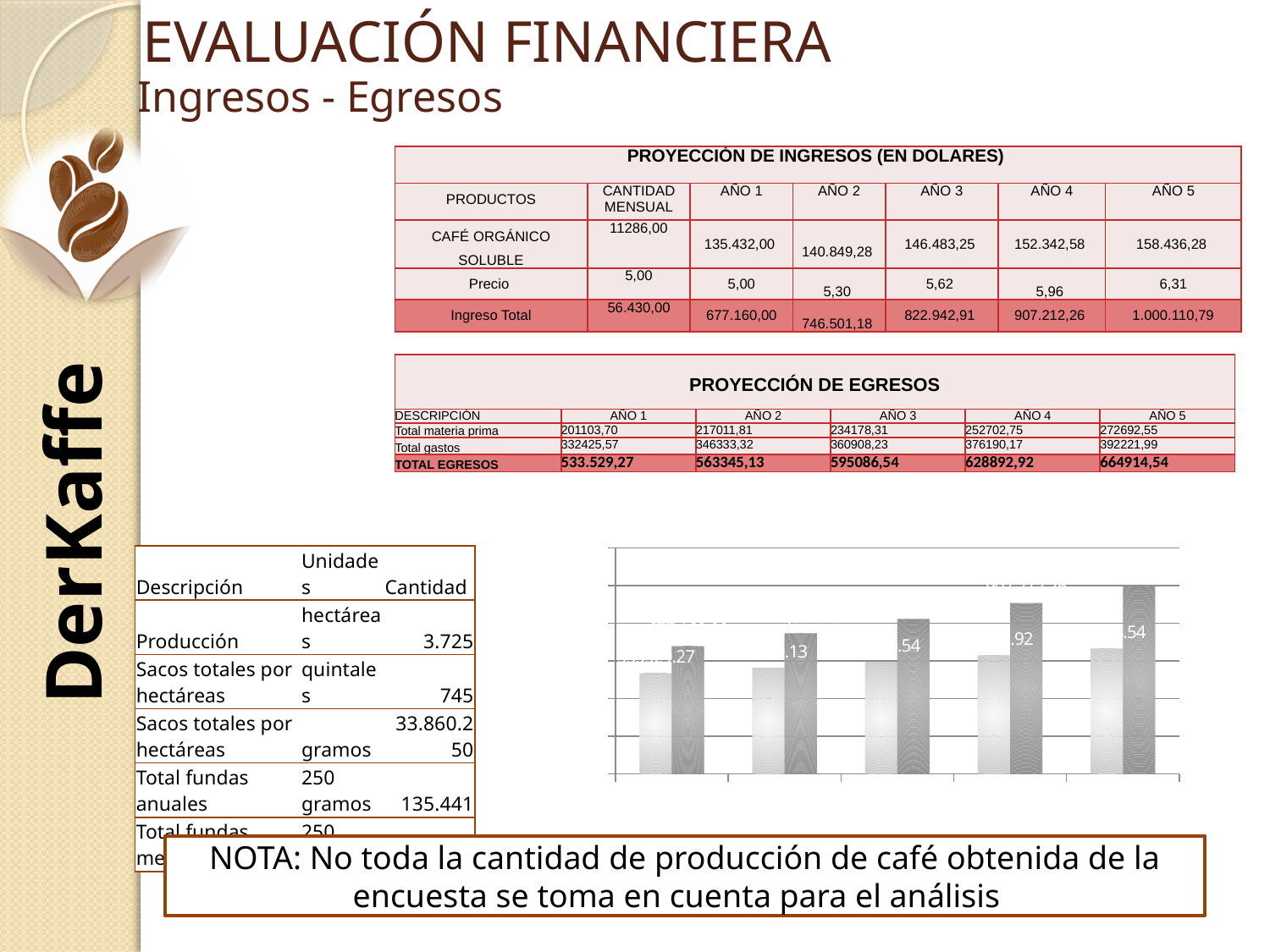
In the bar chart at the bottom right, do the heights of the light bars rise or fall from left to right? rise In the bar chart at the bottom right, within the rightmost group, which bar is taller: the light bar or the dark bar? the dark bar Does the bar chart at the bottom right display a legend? no What kind of chart is shown at the bottom right of the slide? bar chart In the bar chart at the bottom right, is the dark bar taller than the light bar in every group? yes In the bar chart at the bottom right, do the heights of the dark bars rise or fall from left to right? rise In the bar chart at the bottom right, which group of bars contains the tallest bar: the leftmost or the rightmost? rightmost In the bar chart at the bottom right, how many bars are plotted in total? 10 In the bar chart at the bottom right, how many groups of bars are plotted along the x axis? 5 In the bar chart at the bottom right, within the leftmost group, which bar is taller: the light bar or the dark bar? the dark bar In the bar chart at the bottom right, how many bars are there in each group? 2 In the bar chart at the bottom right, which group of bars contains the shortest bar: the leftmost or the rightmost? leftmost